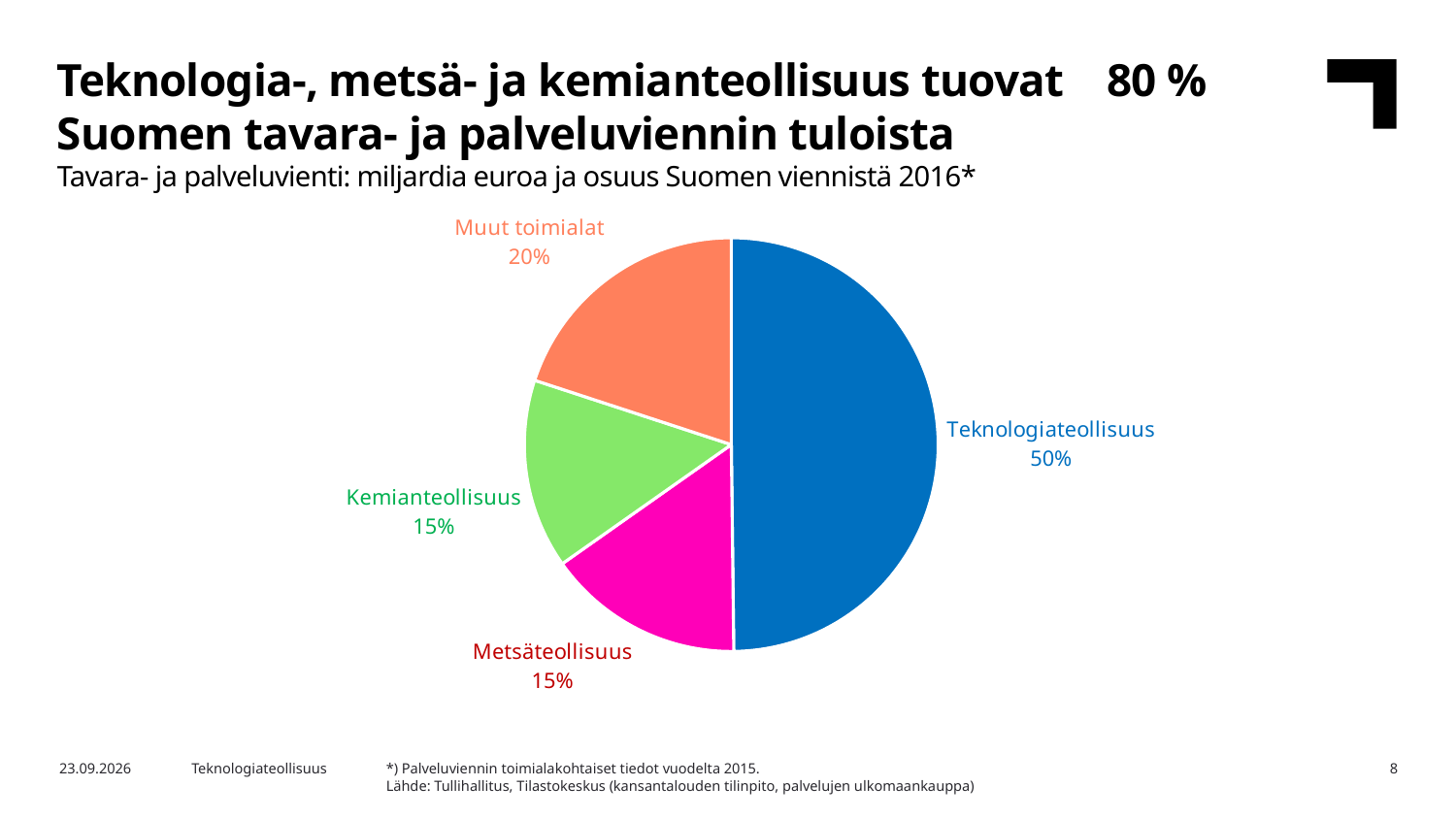
What kind of chart is shown on the slide? pie chart What is the value shown for Metsäteollisuus? 15% Which slice of the pie is the largest? Teknologiateollisuus What is the combined share of Teknologiateollisuus, Metsäteollisuus and Kemianteollisuus? 80% What colour is the Teknologiateollisuus slice? blue Which is larger, the share for Muut toimialat or the share for Kemianteollisuus? Muut toimialat What share of the pie does Teknologiateollisuus have? 50% What is the difference in percentage points between Teknologiateollisuus and Muut toimialat? 30 percentage points How many slices does the pie chart have? 4 What is the subtitle of the chart on the slide? Tavara- ja palveluvienti: miljardia euroa ja osuus Suomen viennistä 2016* What share of the pie does Muut toimialat have? 20% What is the value shown for Kemianteollisuus? 15%